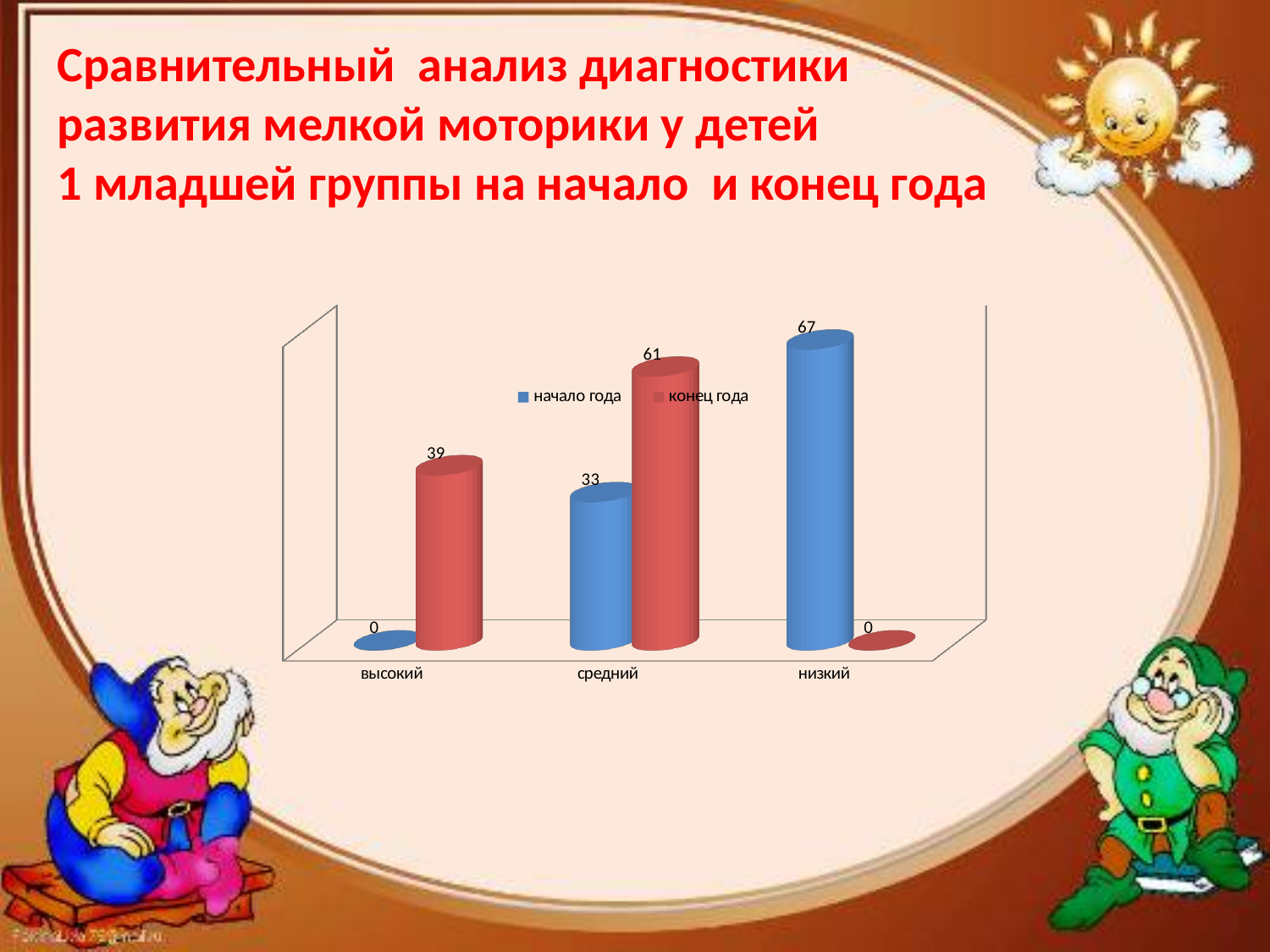
What is the value for "конец года" in the "высокий" category? 39 What kind of chart is shown on the slide? bar chart How many categories are shown on the x axis? 3 Which category has the highest value for "начало года"? низкий What is the value for "конец года" in the "низкий" category? 0 What is the value for "начало года" in the "низкий" category? 67 What is the difference between the "конец года" and "начало года" values in the "средний" category? 28 Which colour represents the "конец года" series? red What is the value for "начало года" in the "средний" category? 33 Which is larger in the "высокий" category: "начало года" or "конец года"? конец года How many series does the legend list? 2 Which category has the lowest value for "конец года"? низкий